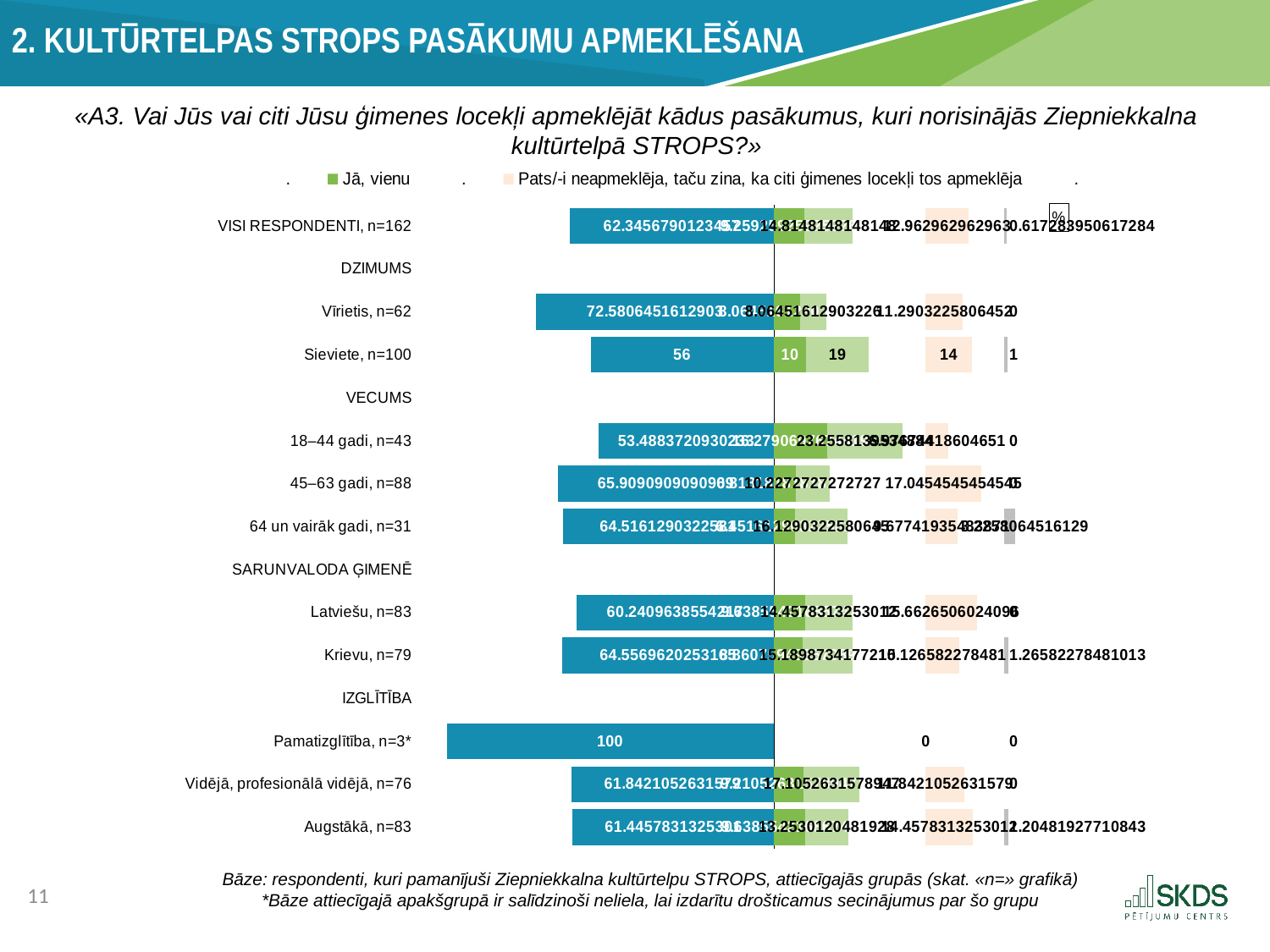
Which group has the largest leftmost (blue) segment? Pamatizglītība, n=3* For the group Sieviete, n=100, what is the difference between the light green segment and the 'Jā, vienu' (green) segment? 9 Which group has the larger leftmost (blue) segment, Vīrietis, n=62 or Sieviete, n=100? Vīrietis, n=62 What is the value of the 'Pats/-i neapmeklēja, taču zina, ka citi ģimenes locekļi tos apmeklēja' (peach) segment for the group Sieviete, n=100? 14 What is the value of the leftmost (blue) segment for the group Sieviete, n=100? 56 What is the value of the leftmost (blue) segment for the group Pamatizglītība, n=3*? 100 How many respondent groups (rows labelled with n=) are plotted in the chart? 11 What is the value of the peach segment for the group Pamatizglītība, n=3*? 0 What kind of chart is shown on the slide? bar chart What is the value of the 'Jā, vienu' (green) segment for the group Sieviete, n=100? 10 What colour is used for the legend entry 'Jā, vienu'? green What is the value of the light green segment for the group Sieviete, n=100? 19